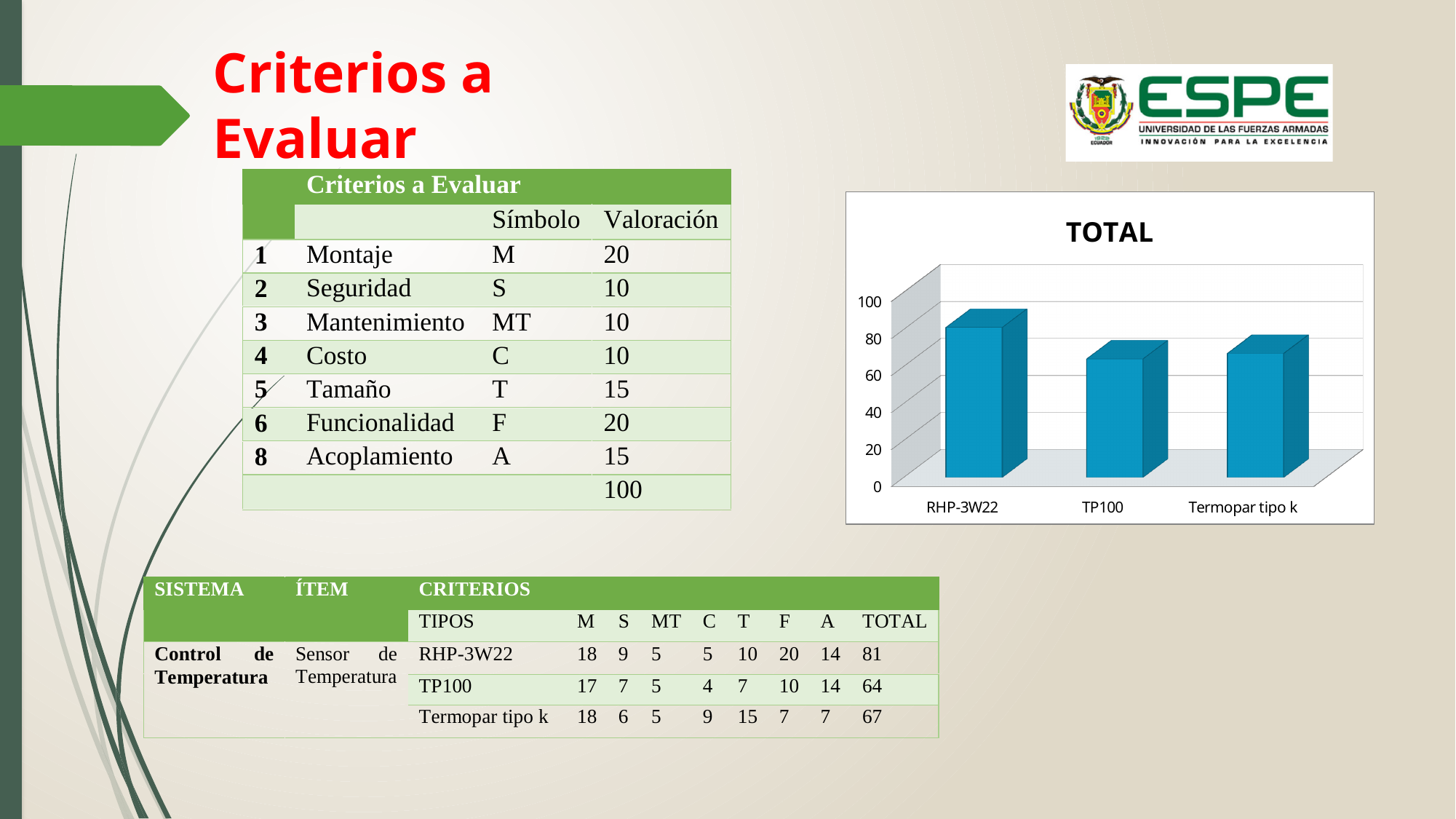
What is the difference between the TOTAL values for RHP-3W22 and TP100? 17 Is the value for RHP-3W22 in the TOTAL chart greater or less than 60? greater In the TOTAL chart, which is larger, the value for RHP-3W22 or the value for TP100? RHP-3W22 What is the TOTAL value for Termopar tipo k plotted in the chart? 67 Which category has the lowest bar in the TOTAL chart? TP100 What is the title of the chart? TOTAL Is the value for Termopar tipo k in the TOTAL chart greater or less than 40? greater How many categories are plotted in the TOTAL chart? 3 What is the TOTAL value for RHP-3W22 plotted in the chart? 81 What kind of chart is shown on the slide? bar chart Which category has the highest bar in the TOTAL chart? RHP-3W22 Is the value for TP100 in the TOTAL chart greater or less than 80? less